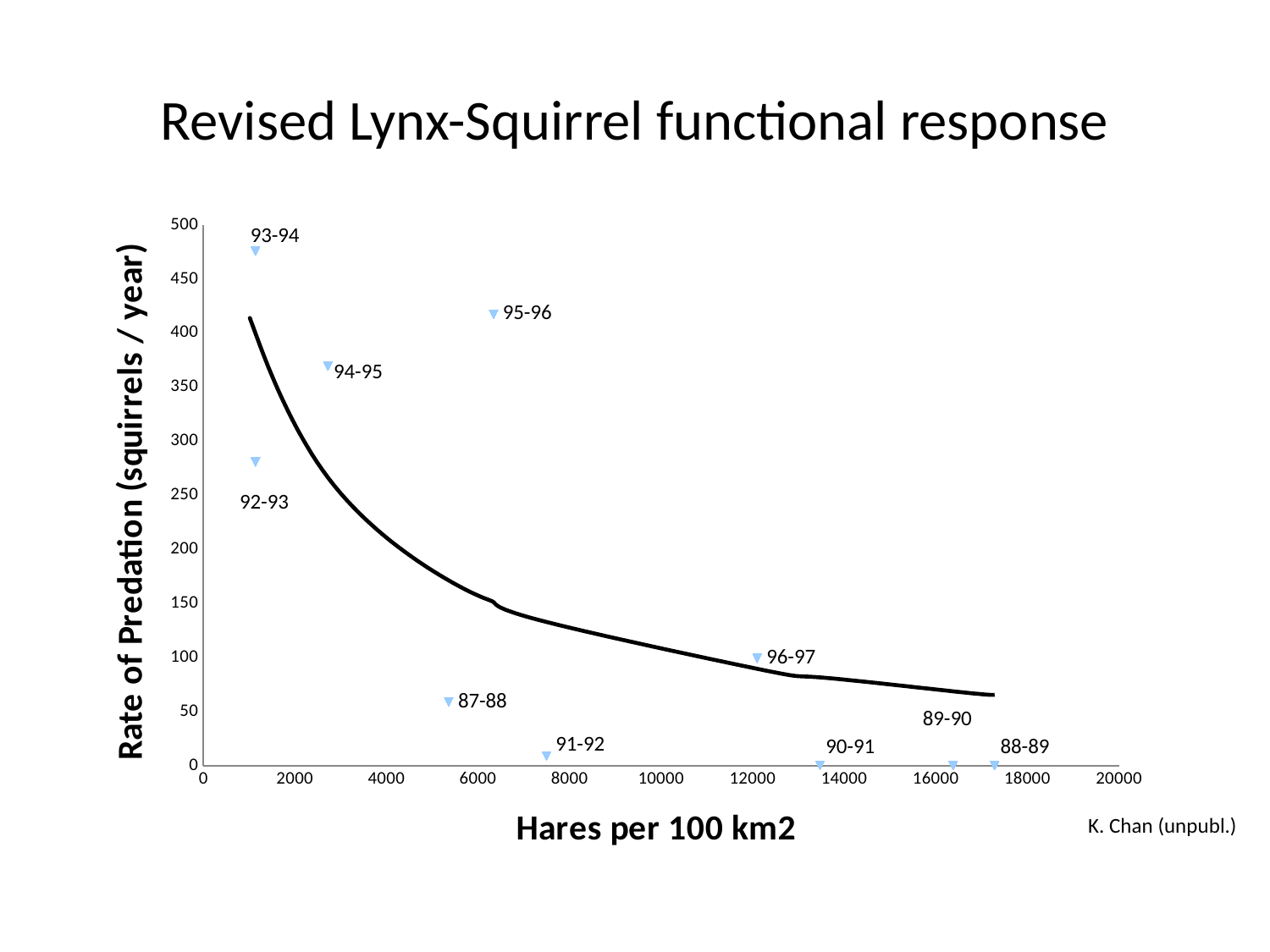
What is the title of the x axis? Hares per 100 km2 What kind of chart is shown on the slide? scatter chart Which labeled point has the highest rate of predation? 93-94 According to the fitted curve, does the rate of predation rise or fall as hares per 100 km2 increases? fall Is the rate of predation for 87-88 greater or less than 100? less Is the rate of predation for 94-95 greater or less than 350? greater How many labeled data points are plotted on the chart? 10 Which has a higher rate of predation, 95-96 or 96-97? 95-96 Is the rate of predation for 96-97 greater or less than 150? less Which has a higher rate of predation, 93-94 or 92-93? 93-94